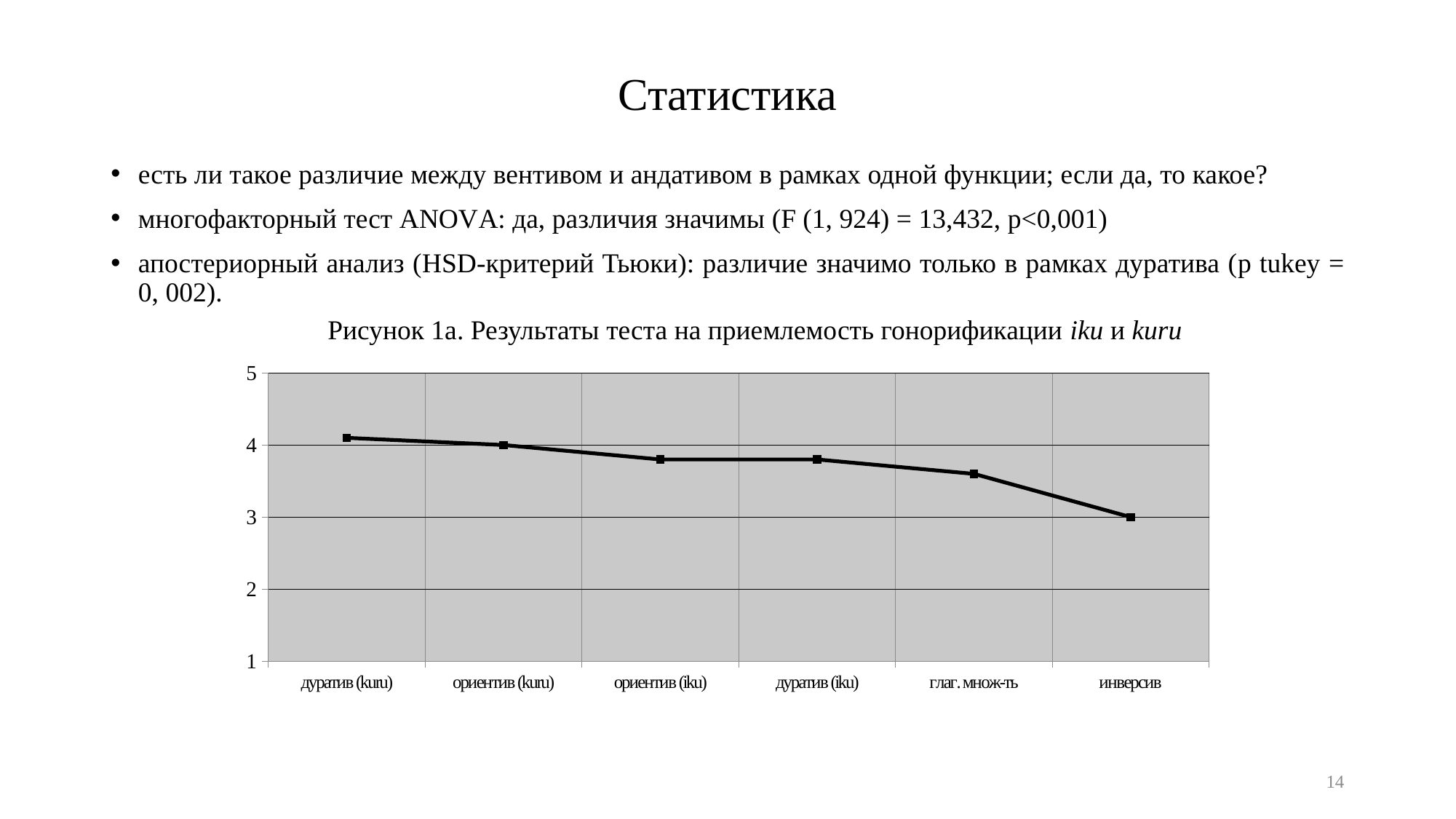
Which is larger, the value for дуратив (kuru) or the value for инверсив? дуратив (kuru) What is the title of the figure shown on the slide? Рисунок 1а. Результаты теста на приемлемость гонорификации iku и kuru Is the value for глаг. множ-ть greater or less than 3? greater Which category has the lowest value in the chart? инверсив Do the values rise or fall from left to right along the x axis? fall What is the value for инверсив? 3 Is the value for ориентив (iku) greater or less than 4? less How many categories are plotted along the x axis of the chart? 6 Is the value for дуратив (kuru) greater or less than 4? greater Which category has the highest value in the chart? дуратив (kuru) What kind of chart is shown on the slide? line chart Which is larger, the value for глаг. множ-ть or the value for инверсив? глаг. множ-ть